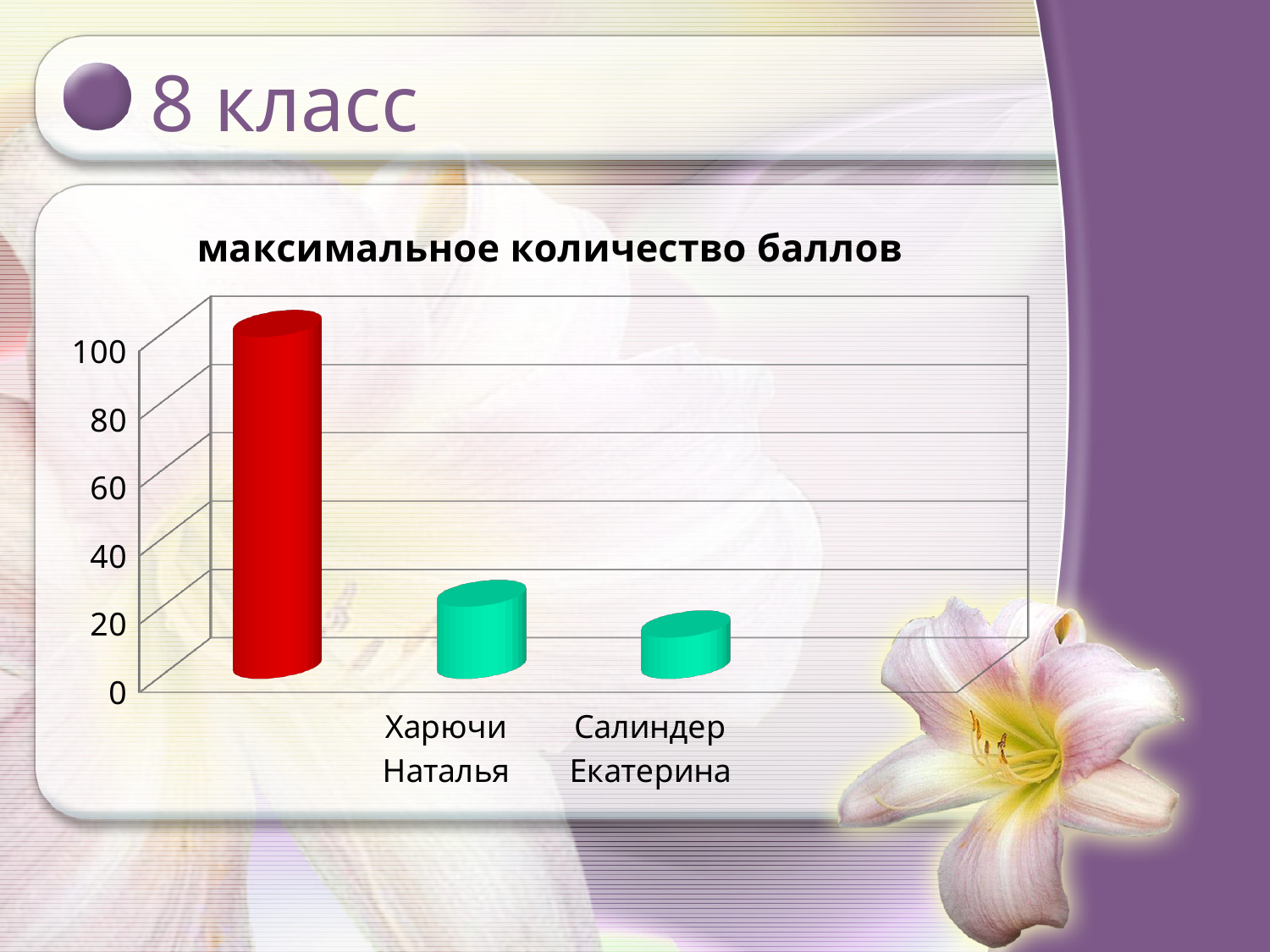
Is the value for Салиндер Екатерина greater or less than 40? less Is the value for Харючи Наталья greater or less than 40? less Is the value for Харючи Наталья greater or less than 60? less What kind of chart is shown on the slide? bar chart What is the title of the chart? максимальное количество баллов Which is larger, the value for Харючи Наталья or the value for Салиндер Екатерина? Харючи Наталья How many bars are plotted in the chart? 3 Which labelled category has the lowest value? Салиндер Екатерина What is the highest tick value shown on the vertical axis? 100